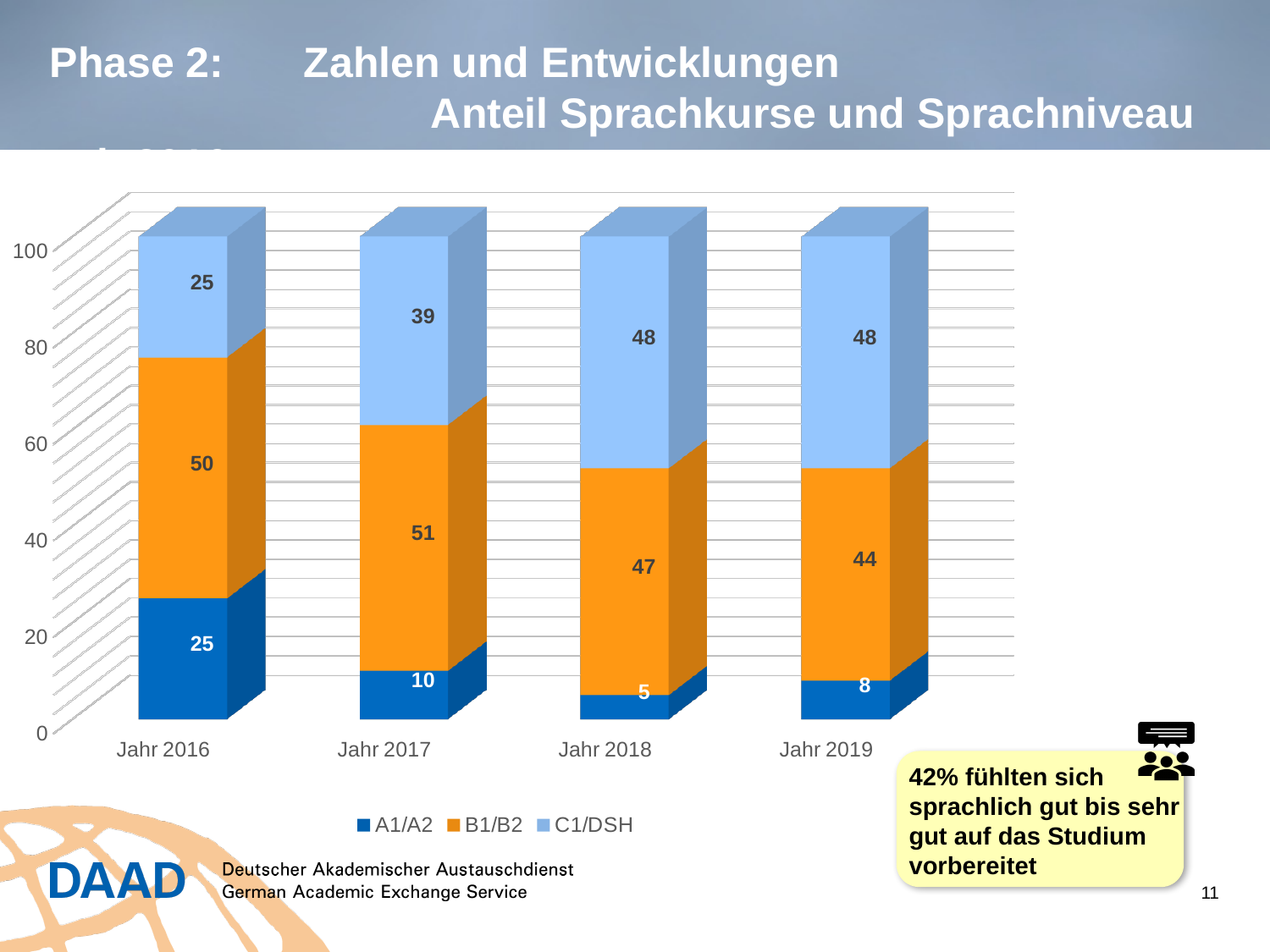
What is the value for C1/DSH in Jahr 2017? 39 In which year is the C1/DSH value lowest? Jahr 2016 In which year is the B1/B2 value highest? Jahr 2017 What is the value for A1/A2 in Jahr 2018? 5 Which is larger, the A1/A2 value for Jahr 2017 or for Jahr 2019? Jahr 2017 What is the total of the stacked bar for Jahr 2017? 100 What is the difference between the C1/DSH values for Jahr 2018 and Jahr 2016? 23 What is the value for B1/B2 in Jahr 2019? 44 What is the value for A1/A2 in Jahr 2016? 25 How many years are shown on the x axis? 4 How many series does the legend list? 3 What kind of chart is shown on the slide? Stacked bar chart